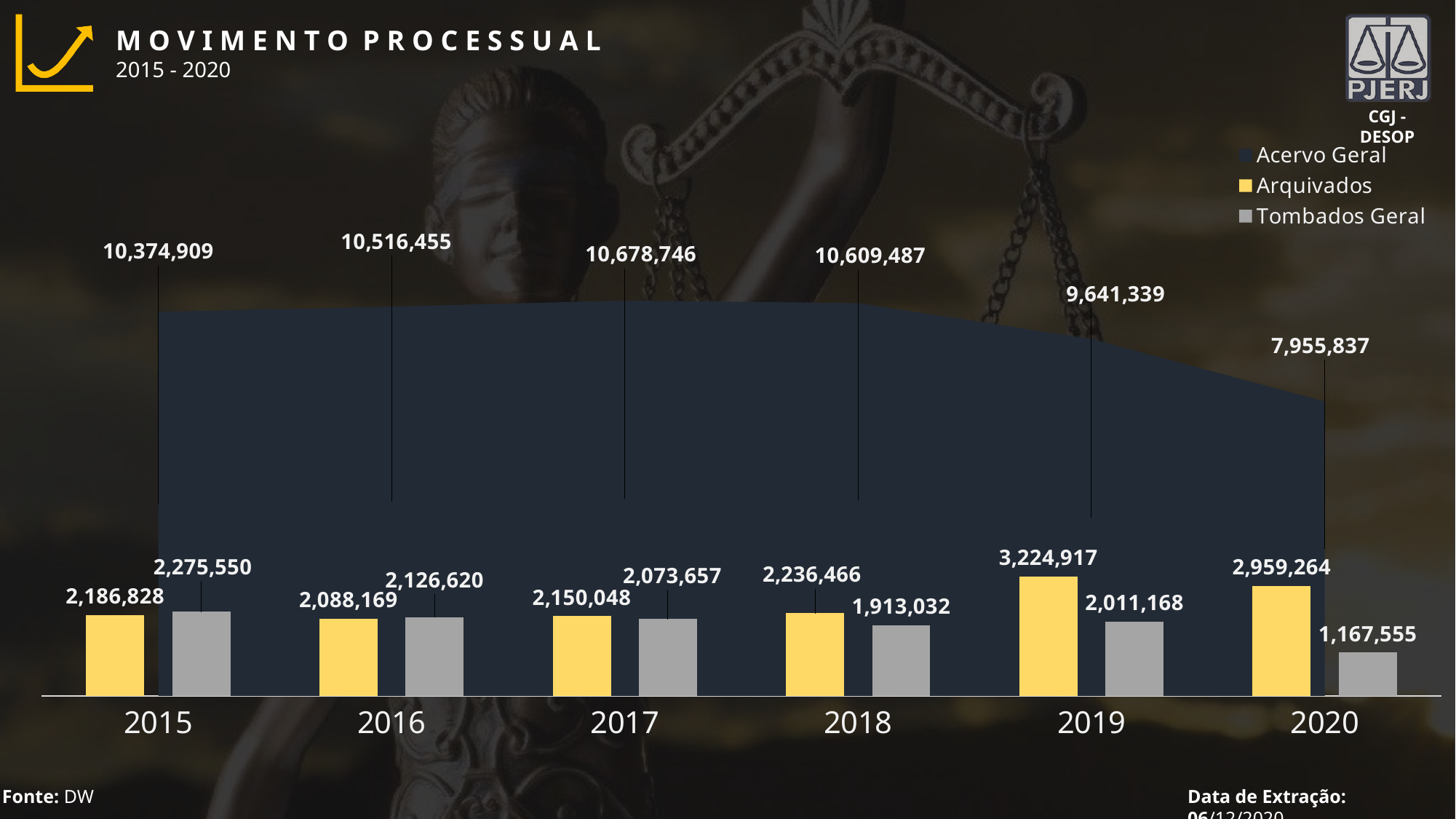
What is the Tombados Geral value for 2020? 1,167,555 What is the Acervo Geral value for 2017? 10,678,746 By how much did the Acervo Geral fall from 2017 to 2020? 2,722,909 How many years are shown on the x axis? 6 What is the Arquivados value for 2019? 3,224,917 In 2015, which is larger: Arquivados or Tombados Geral? Tombados Geral Does the Acervo Geral rise or fall from 2018 to 2020? fall In which year is the Arquivados value highest? 2019 In which year is the Tombados Geral value lowest? 2020 What is the difference between Arquivados and Tombados Geral in 2019? 1,213,749 In which year is the Acervo Geral highest? 2017 How many series does the legend list? 3